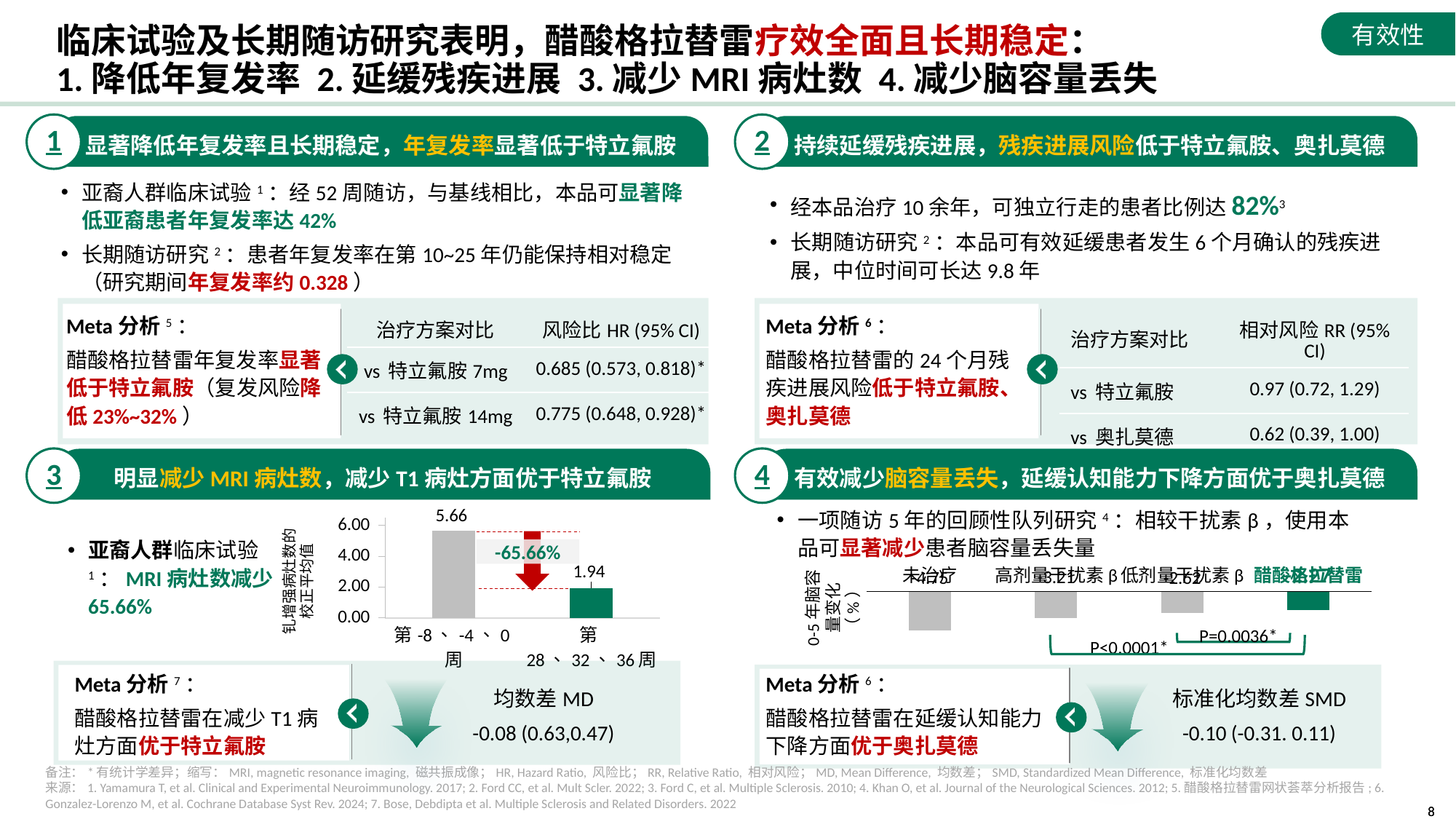
In the MRI lesion bar chart in section 3, what is the difference between the values for 第-8、-4、0周 and 第28、32、36周? 3.72 In the MRI lesion bar chart in section 3, how many bars are plotted? 2 In the MRI lesion bar chart in section 3, do the values rise or fall from left to right? fall In the MRI lesion bar chart in section 3, which category has the higher value? 第-8、-4、0周 What kind of chart is shown in section 3 (MRI 病灶数)? bar chart In the MRI lesion bar chart in section 3, what is the value for 第28、32、36周? 1.94 In the MRI lesion bar chart in section 3, is the value for 第28、32、36周 greater or less than 2.00? less In the brain volume change bar chart in section 4, how many categories are plotted? 4 In the MRI lesion bar chart in section 3, what percentage change is annotated between the two bars? -65.66% In the MRI lesion bar chart in section 3, what is the value for 第-8、-4、0周? 5.66 In the MRI lesion bar chart in section 3, which category has the lowest value? 第28、32、36周 In the brain volume change bar chart in section 4, which category has the shortest bar (smallest brain volume loss)? 醋酸格拉替雷